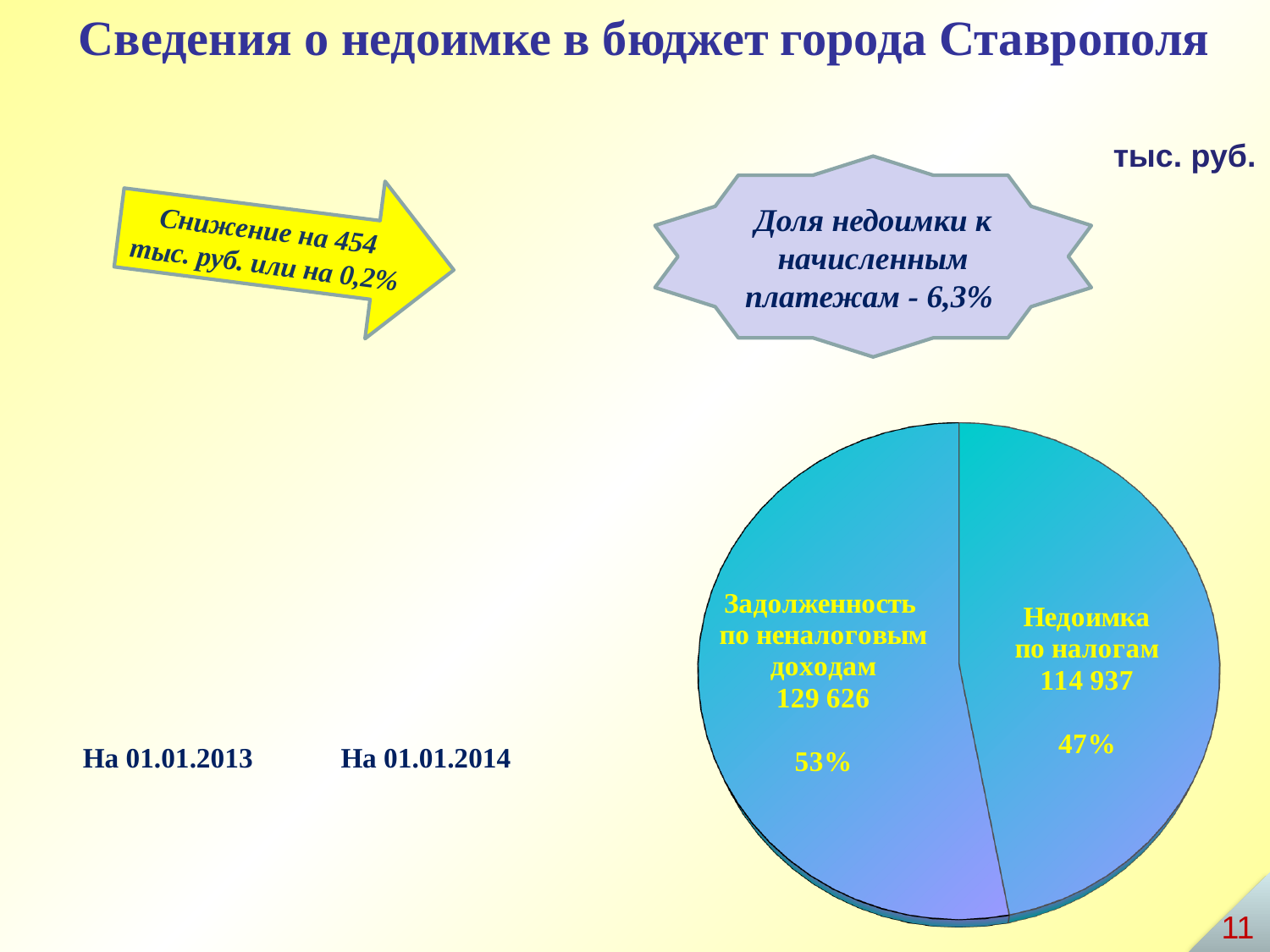
Which slice of the pie chart is the smallest? Недоимка по налогам What is the difference between the values for "Задолженность по неналоговым доходам" and "Недоимка по налогам"? 14 689 What unit is indicated for the values on the slide? тыс. руб. What share of the pie does "Задолженность по неналоговым доходам" represent? 53% What is the total of the two slices in the pie chart? 244 563 What is the value for "Задолженность по неналоговым доходам" in the pie chart? 129 626 Which slice of the pie chart is the largest? Задолженность по неналоговым доходам What kind of chart is shown on the slide? pie chart What share of the pie does "Недоимка по налогам" represent? 47% How many slices does the pie chart have? 2 Which is larger: "Задолженность по неналоговым доходам" or "Недоимка по налогам"? Задолженность по неналоговым доходам What is the value for "Недоимка по налогам" in the pie chart? 114 937